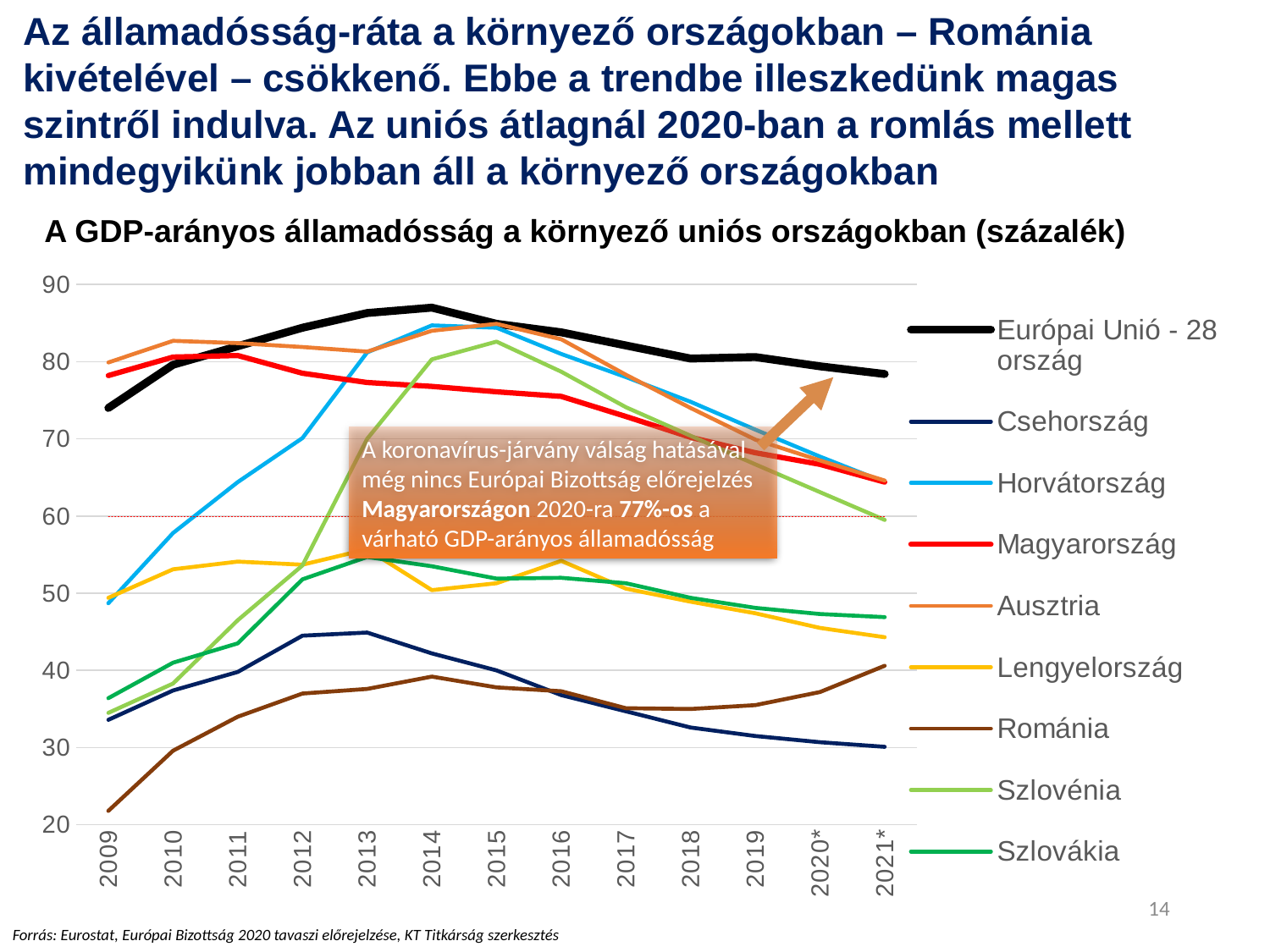
Does the value for Magyarország rise or fall from 2011 to 2021*? fall Is the value for Románia in 2009 greater or less than 30? less Which series has the lowest value in 2021*? Csehország How many series does the legend list? 9 What is the title of the chart? A GDP-arányos államadósság a környező uniós országokban (százalék) How many years are shown on the x axis? 13 What kind of chart is shown on the slide? line chart Which series has the lowest value in 2009? Románia Which series has the highest value in 2014? Európai Unió - 28 ország Is the value for Csehország in 2021* greater or less than 40? less Is the value for Európai Unió - 28 ország in 2014 greater or less than 80? greater Which is larger in 2021*, the value for Románia or the value for Csehország? Románia